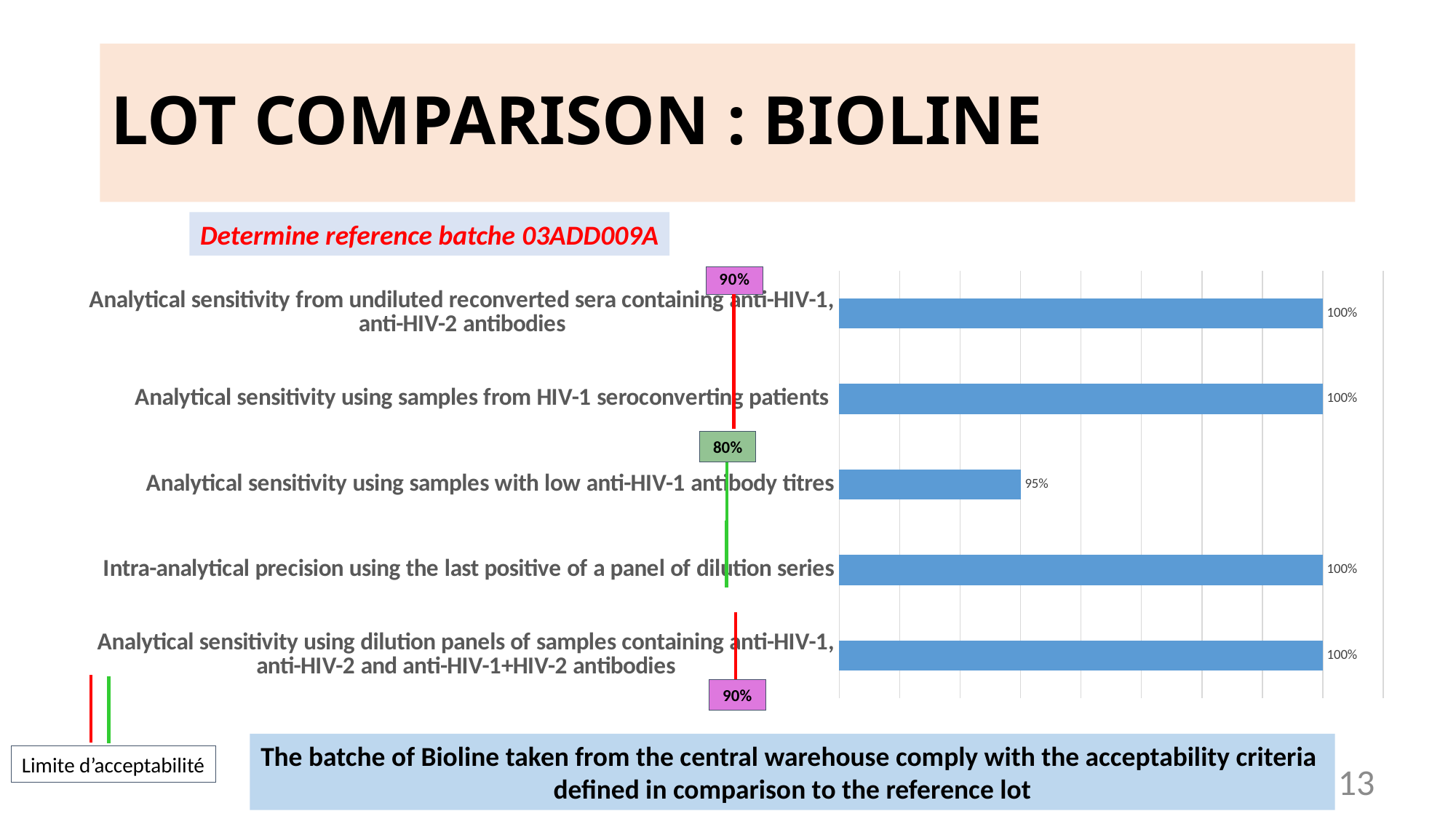
How many categories are plotted in the chart? 5 What value is shown for 'Analytical sensitivity using samples with low anti-HIV-1 antibody titres'? 95% What value is shown for 'Analytical sensitivity from undiluted reconverted sera containing anti-HIV-1, anti-HIV-2 antibodies'? 100% Which is larger: the value for 'Analytical sensitivity using samples from HIV-1 seroconverting patients' or the value for 'Analytical sensitivity using samples with low anti-HIV-1 antibody titres'? Analytical sensitivity using samples from HIV-1 seroconverting patients What acceptability limit is marked by the green line next to the chart? 80% Which category has the lowest value in the chart? Analytical sensitivity using samples with low anti-HIV-1 antibody titres What kind of chart is shown on the slide? Bar chart What is the difference between the value for 'Intra-analytical precision using the last positive of a panel of dilution series' and the value for 'Analytical sensitivity using samples with low anti-HIV-1 antibody titres'? 5% What value is shown for 'Intra-analytical precision using the last positive of a panel of dilution series'? 100% What value is shown for 'Analytical sensitivity using dilution panels of samples containing anti-HIV-1, anti-HIV-2 and anti-HIV-1+HIV-2 antibodies'? 100% How many of the plotted categories have a value of 100%? 4 What value is shown for 'Analytical sensitivity using samples from HIV-1 seroconverting patients'? 100%